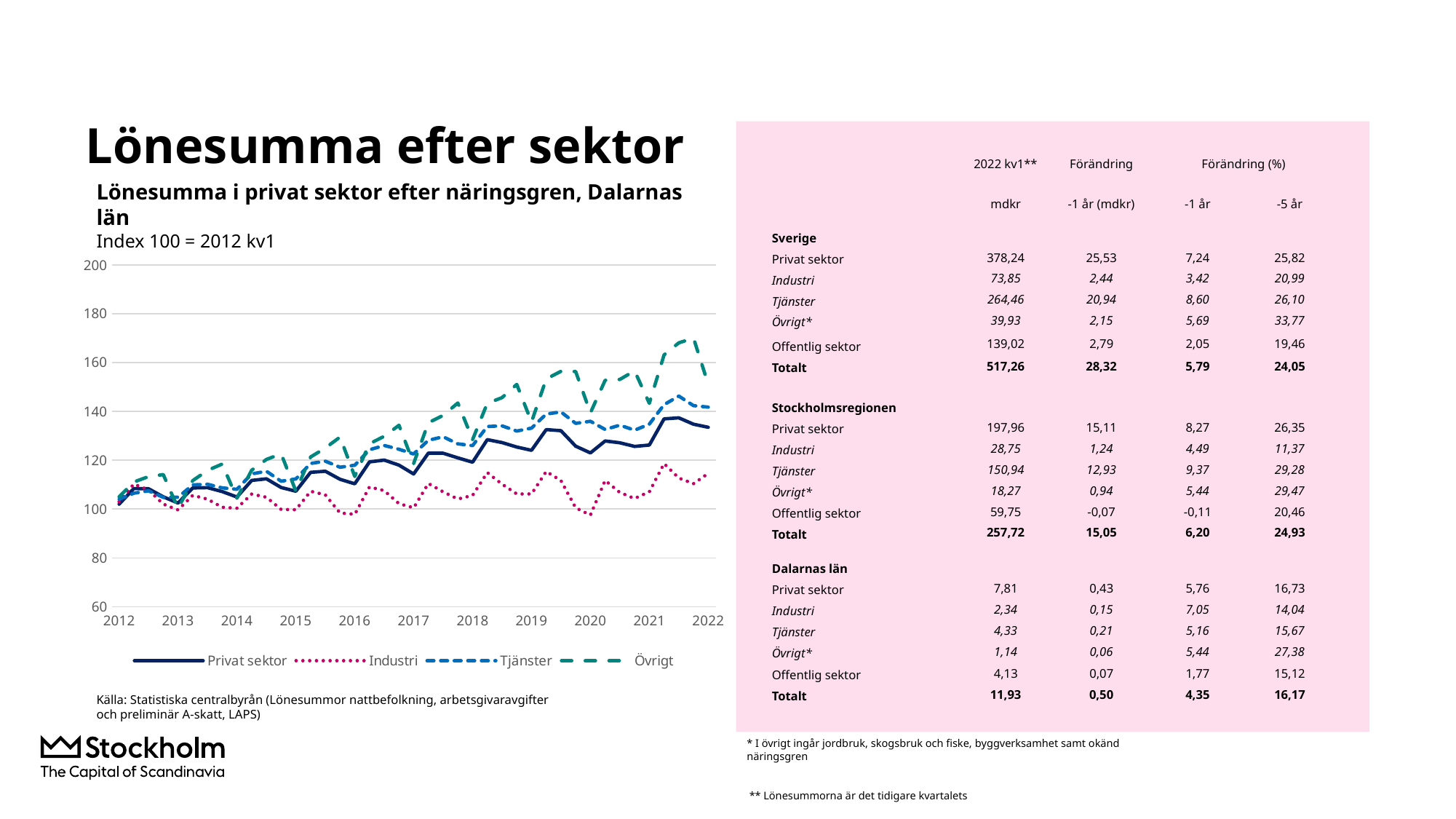
Which series is plotted with the highest values at the end of the chart in 2022? Övrigt Is the value for Industri at the end of 2022 greater or less than 120? less Which series is plotted with the lowest values at the end of the chart in 2022? Industri Does the Privat sektor line generally rise or fall from 2012 to 2022? rise Is the value for Övrigt at the end of 2022 greater or less than 140? greater At the end of 2022, which series has the larger value, Övrigt or Industri? Övrigt How many year labels are shown on the x axis of the chart? 11 What base period does the chart's index use (Index 100)? 2012 kv1 What kind of chart is shown on the slide? line chart Is the value for Privat sektor at the end of 2022 greater or less than 120? greater How many series does the chart legend list? 4